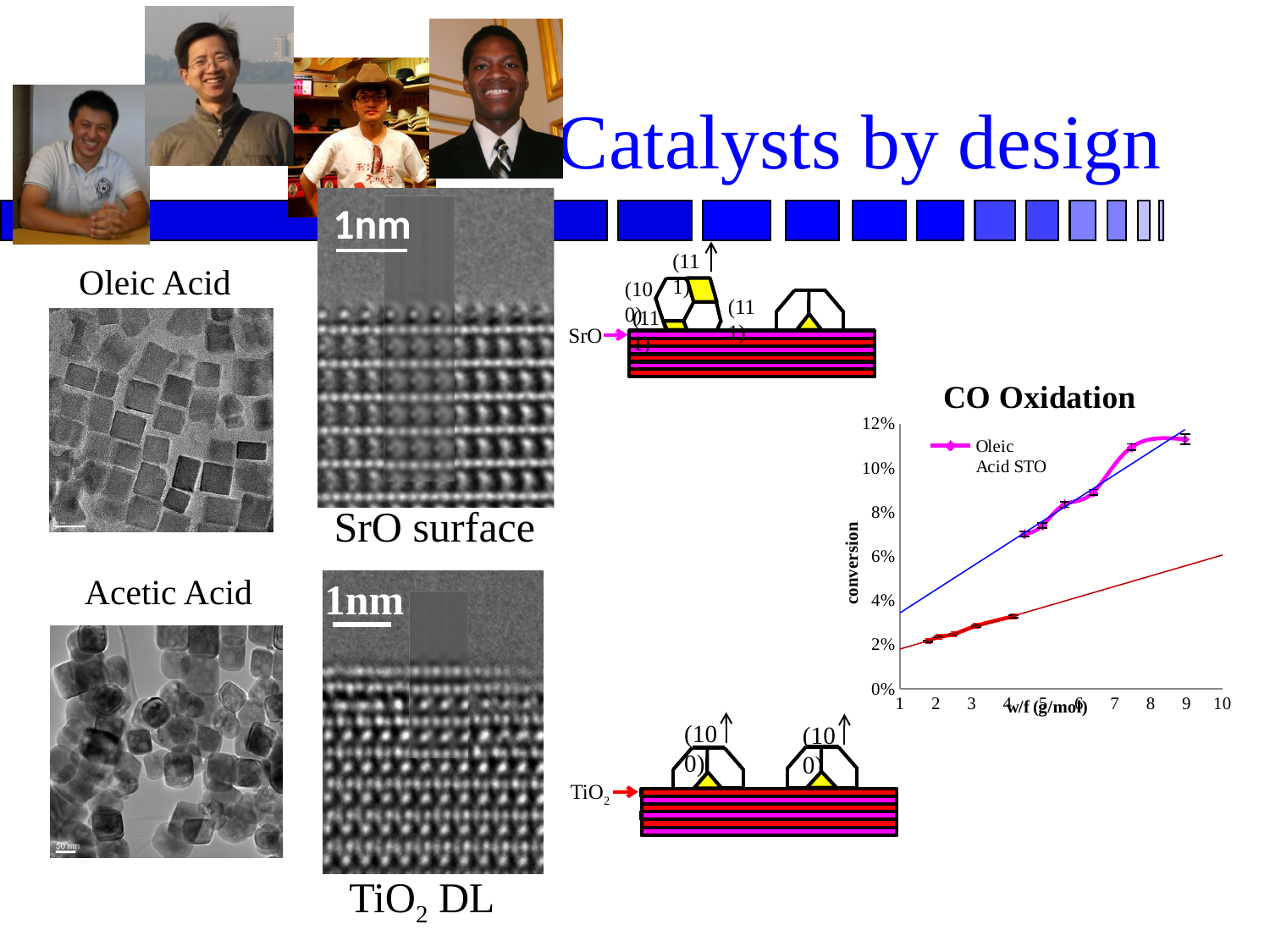
What series name appears in the legend of the CO Oxidation chart? Oleic Acid STO In the CO Oxidation chart, is the Oleic Acid STO conversion at w/f 9 greater or less than 10%? greater What is the title of the chart on the slide? CO Oxidation In the CO Oxidation chart, is the Oleic Acid STO conversion at w/f 7.5 greater or less than 10%? greater In the CO Oxidation chart, is the conversion of the red (lower) series at w/f 2 greater or less than 4%? less How many series does the legend of the CO Oxidation chart list? 1 What is the highest value shown on the y axis of the CO Oxidation chart? 12% In the CO Oxidation chart, which series has the higher conversion at w/f 4: the magenta Oleic Acid STO series or the red series? Oleic Acid STO What kind of chart is the CO Oxidation chart? line chart In the CO Oxidation chart, does the Oleic Acid STO conversion rise or fall as w/f increases? rise